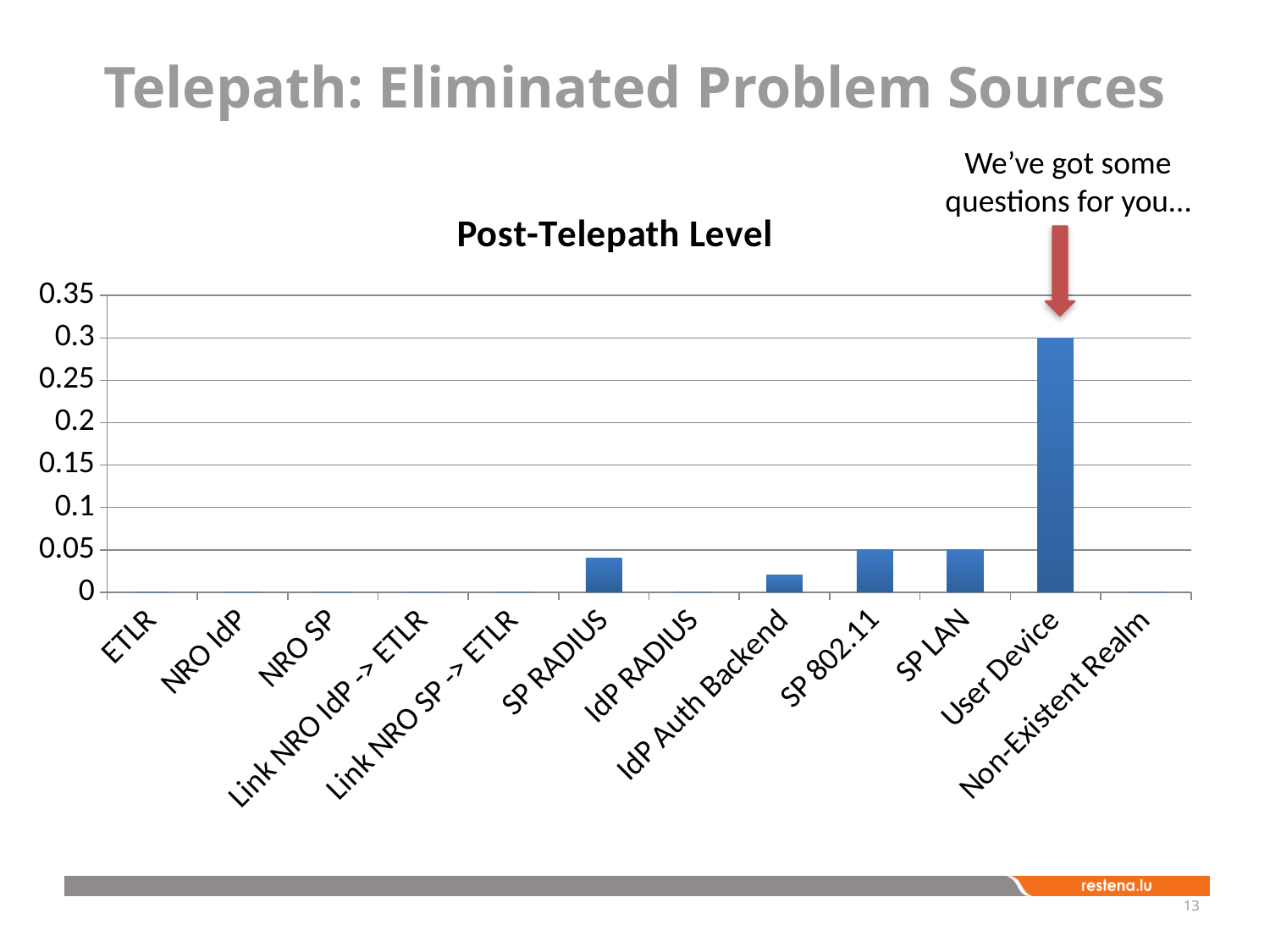
What is the title of the chart? Post-Telepath Level Is the value for IdP Auth Backend greater or less than 0.05? less What is the difference between the values for User Device and SP LAN? 0.25 How many categories are shown on the x axis of the chart? 12 What is the value for User Device? 0.3 What is the value for SP 802.11? 0.05 Which has the larger value, SP RADIUS or IdP Auth Backend? SP RADIUS What is the value for SP LAN? 0.05 Which category has the highest value in the chart? User Device Which category does the red arrow on the slide point to? User Device What kind of chart is shown on the slide? bar chart Is the value for SP RADIUS greater or less than 0.05? less